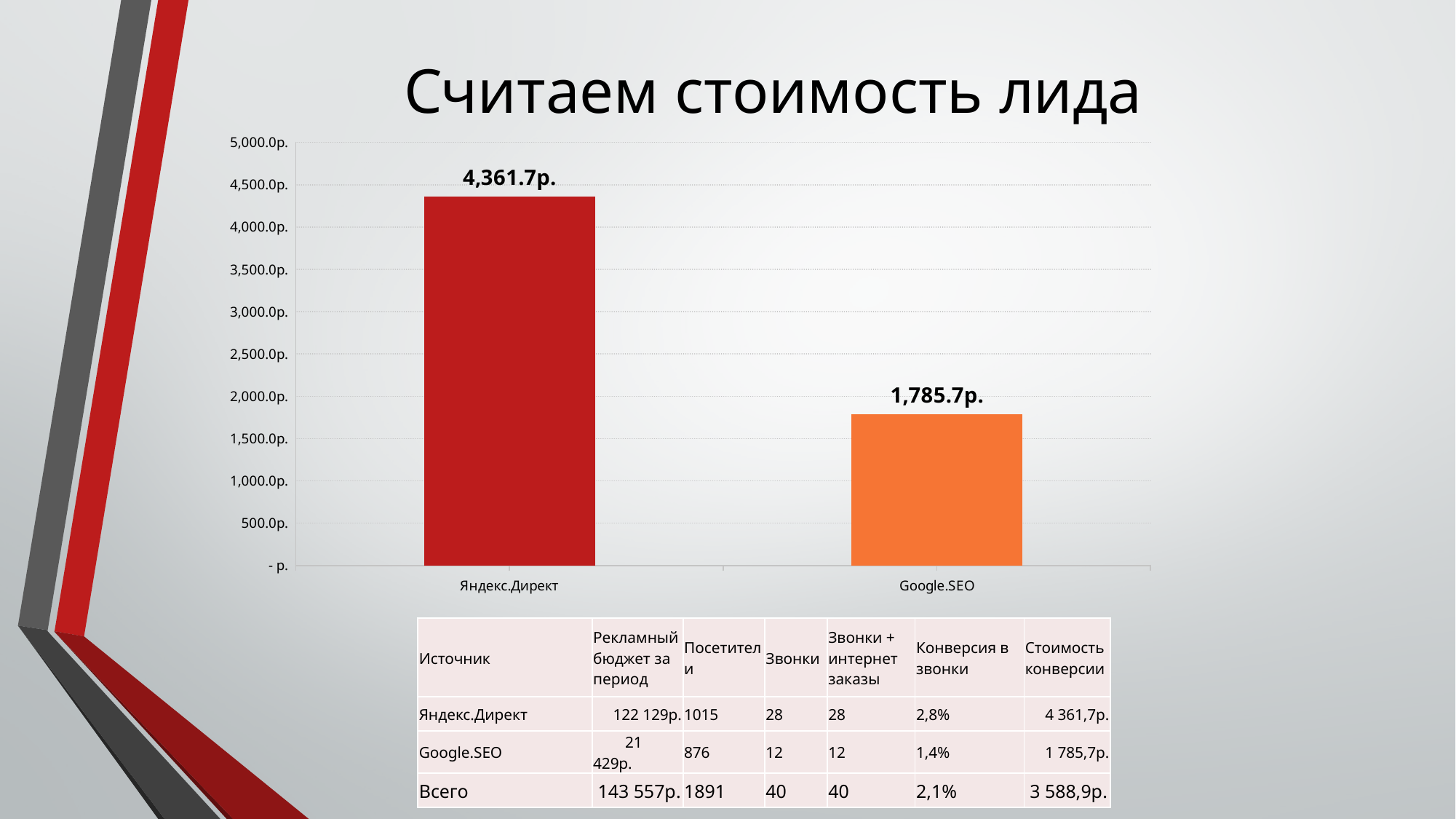
Which category has the lowest value on the chart? Google.SEO Is the value for Google.SEO greater or less than 2,000.0р.? less Is the value for Яндекс.Директ greater or less than 4,000.0р.? greater What is the value shown for Google.SEO on the chart? 1,785.7р. What colour is the bar for Google.SEO? orange What is the title of the slide containing the chart? Считаем стоимость лида What is the difference between the values for Яндекс.Директ and Google.SEO? 2,576.0р. How many categories are plotted on the chart? 2 Which category has the highest value on the chart? Яндекс.Директ Which is larger, the value for Яндекс.Директ or the value for Google.SEO? Яндекс.Директ What kind of chart is shown on the slide? bar chart What is the value shown for Яндекс.Директ on the chart? 4,361.7р.